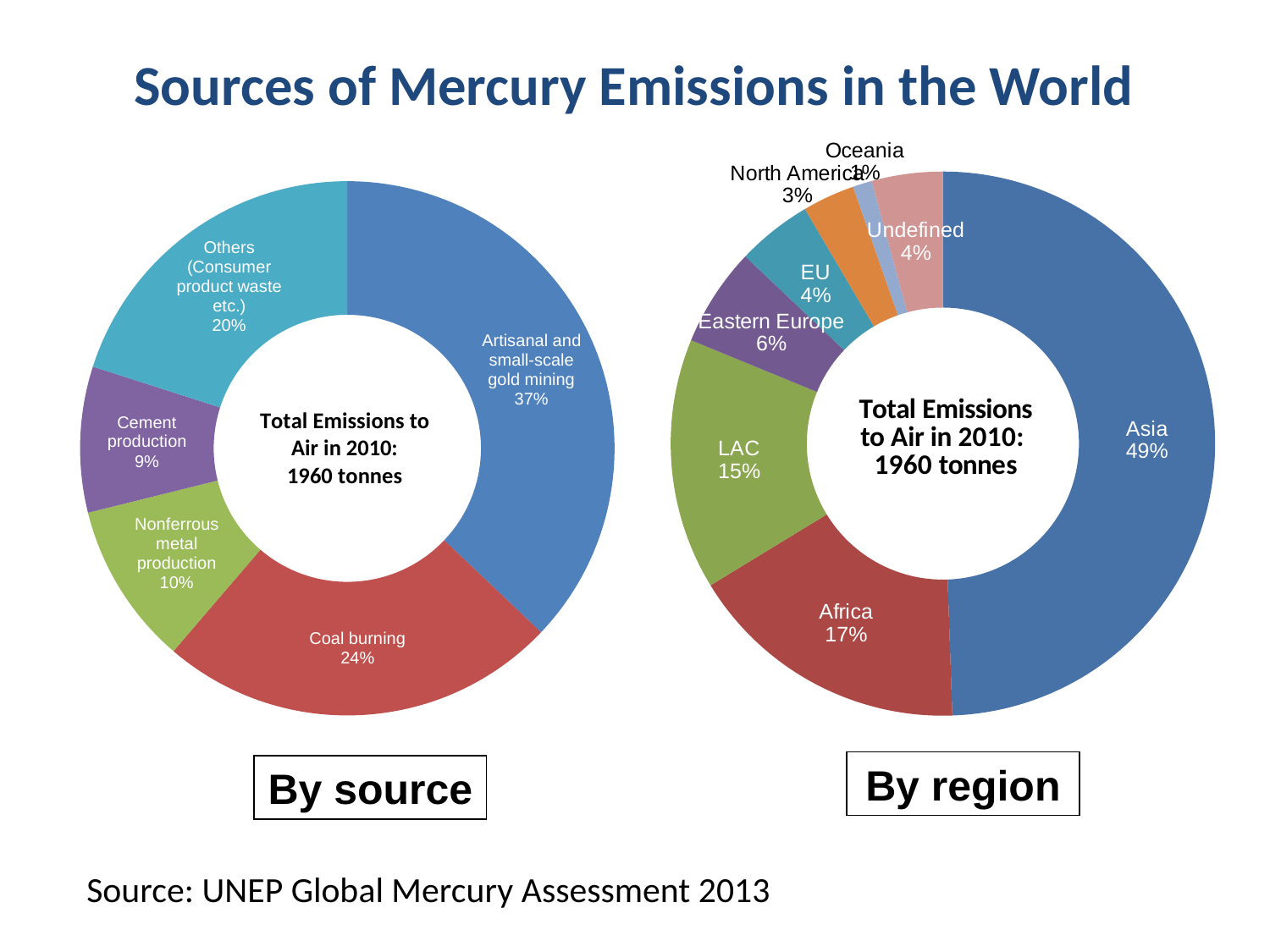
How many categories are shown in the 'By source' chart? 5 In the 'By source' chart, what share of mercury emissions comes from coal burning? 24% In the 'By source' chart, which source has the smallest share? Cement production In the 'By region' chart, what percentage is labelled as Undefined? 4% In the 'By region' chart, which region has the largest share? Asia In the 'By source' chart, which is larger: nonferrous metal production or cement production? Nonferrous metal production In the 'By region' chart, what share of emissions comes from Asia? 49% In the 'By source' chart, what percentage is attributed to artisanal and small-scale gold mining? 37% In the 'By region' chart, what is the difference in percentage points between Africa and LAC? 2 In the 'By source' chart, what is the difference in percentage points between artisanal and small-scale gold mining and coal burning? 13 According to the text in the centre of the charts, what were the total emissions to air in 2010? 1960 tonnes What kind of chart is used on this slide? Pie chart (doughnut)